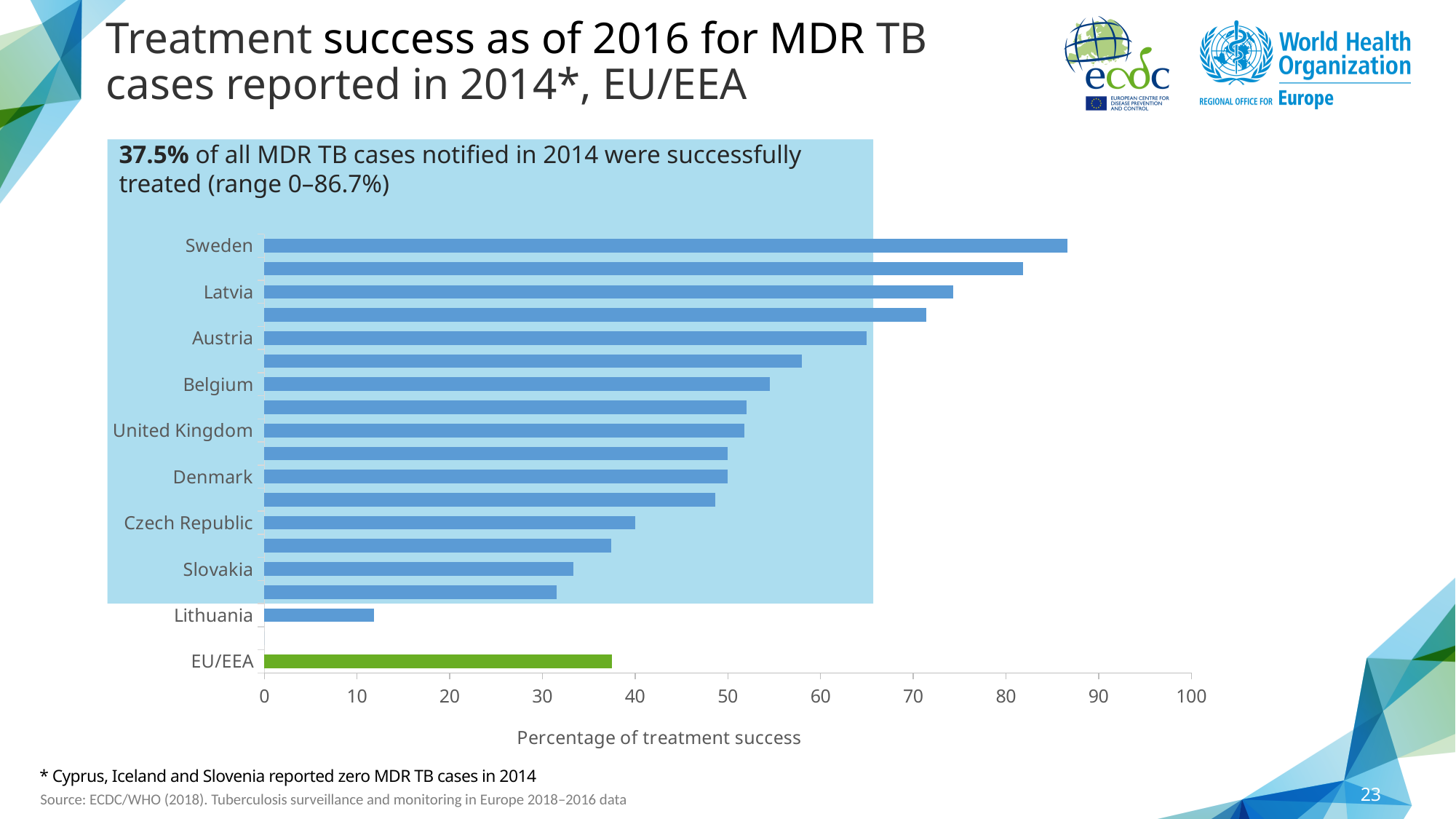
Is the value for Slovakia greater or less than 40? less Which has a higher percentage of treatment success, Slovakia or Lithuania? Slovakia Which country has the highest percentage of treatment success? Sweden Which labelled country has the lowest percentage of treatment success? Lithuania Is the value for Austria greater or less than 60? greater Which has a higher percentage of treatment success, Austria or Belgium? Austria What is the percentage of treatment success for EU/EEA? 37.5% What is the title of the horizontal axis? Percentage of treatment success Is the value for Sweden greater or less than 80? greater What kind of chart is shown on the slide? Bar chart